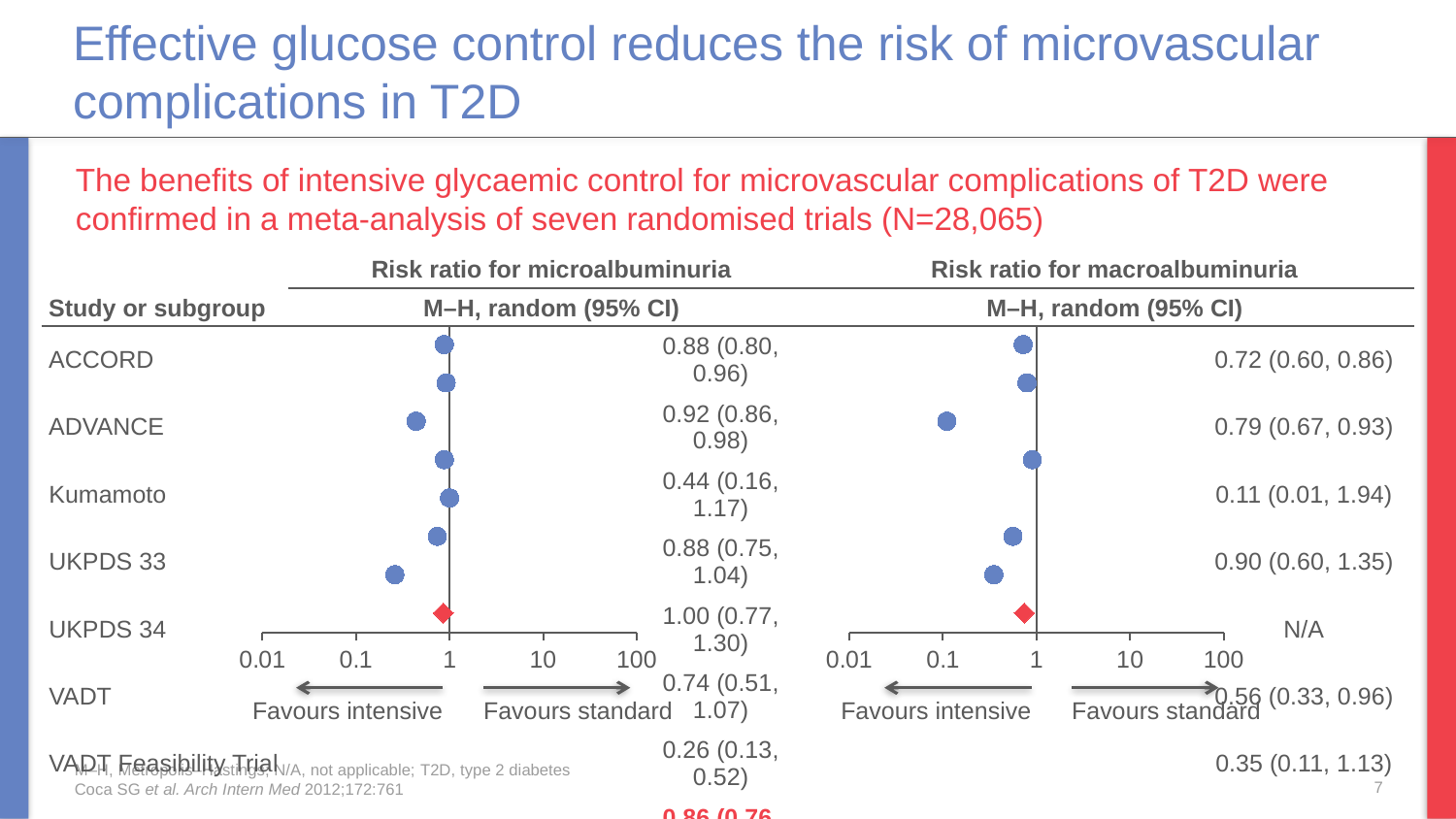
In the risk ratio for microalbuminuria chart, what is the risk ratio (95% CI) for the VADT Feasibility Trial? 0.26 (0.13, 0.52) In the risk ratio for macroalbuminuria chart, what is the risk ratio (95% CI) for ADVANCE? 0.79 (0.67, 0.93) In the risk ratio for microalbuminuria chart, which study has the highest point estimate of the risk ratio? UKPDS 34 In the risk ratio for macroalbuminuria chart, which study has a larger point estimate, UKPDS 33 or VADT? UKPDS 33 How many studies or subgroups are listed in the forest plots? 7 In the risk ratio for macroalbuminuria chart, which study has a value of N/A? UKPDS 34 In the risk ratio for microalbuminuria chart, what is the risk ratio (95% CI) for ACCORD? 0.88 (0.80, 0.96) In the risk ratio for macroalbuminuria chart, which study has the lowest point estimate of the risk ratio? Kumamoto In the risk ratio for microalbuminuria chart, what is the difference between the point estimates for ADVANCE and ACCORD? 0.04 In the risk ratio for macroalbuminuria chart, what is the risk ratio (95% CI) for Kumamoto? 0.11 (0.01, 1.94) What do the arrow labels below the x axis of each chart say? Favours intensive and Favours standard In the risk ratio for microalbuminuria chart, which study has the lowest point estimate of the risk ratio? VADT Feasibility Trial